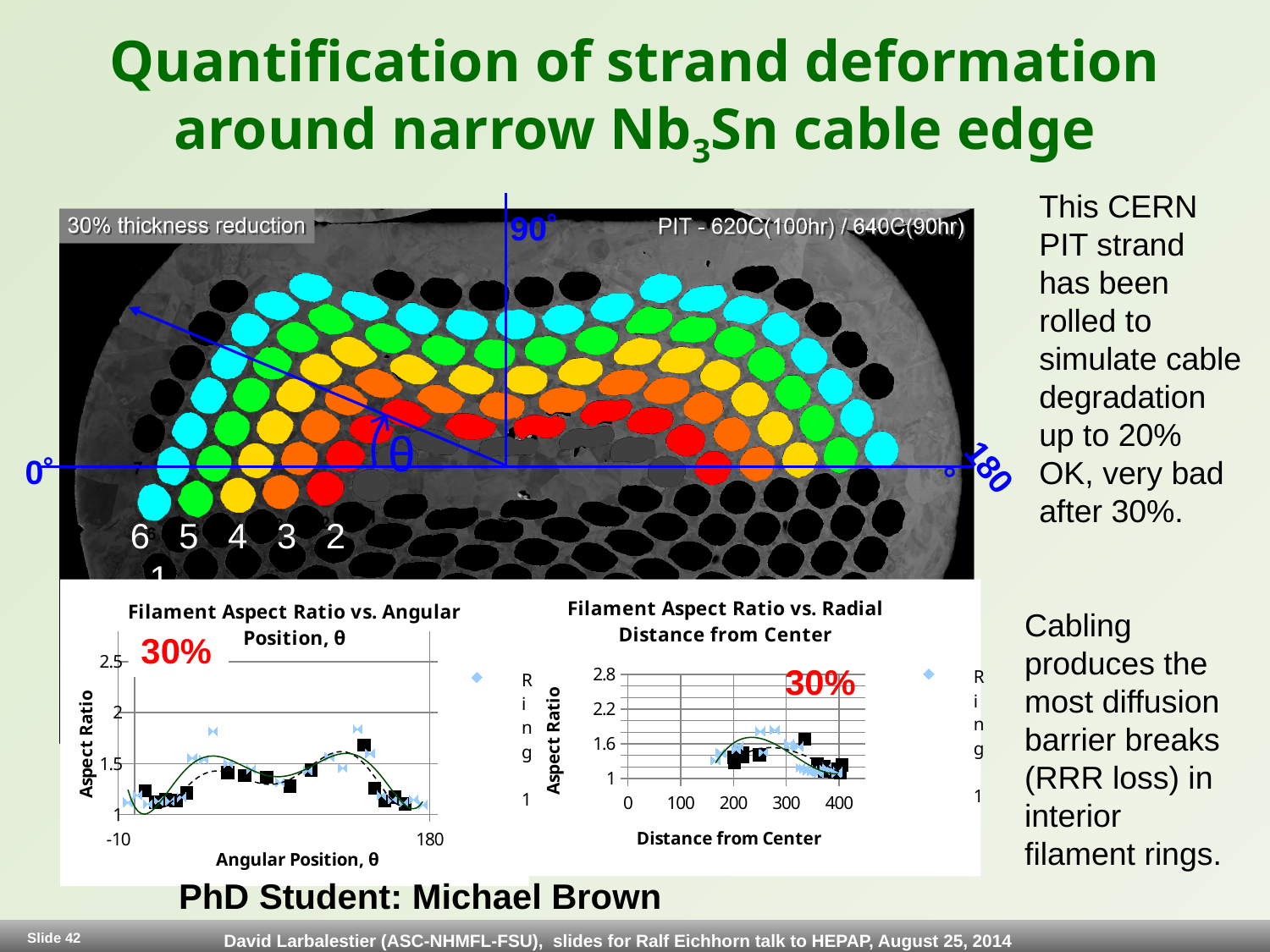
In the left chart (Filament Aspect Ratio vs. Angular Position), what are the minimum and maximum tick values shown on the x axis? -10 and 180 What kind of chart is the right chart titled "Filament Aspect Ratio vs. Radial Distance from Center"? scatter chart In the left chart (Filament Aspect Ratio vs. Angular Position), what is the label on the y axis? Aspect Ratio What kind of chart is the left chart titled "Filament Aspect Ratio vs. Angular Position, θ"? scatter chart In the right chart (Filament Aspect Ratio vs. Radial Distance from Center), what is the label on the x axis? Distance from Center In the left chart (Filament Aspect Ratio vs. Angular Position), is the highest plotted aspect ratio greater or less than 2? less In the right chart (Filament Aspect Ratio vs. Radial Distance from Center), are the plotted points at a distance of about 400 greater or less than 1.6 in aspect ratio? less In the right chart (Filament Aspect Ratio vs. Radial Distance from Center), what is the largest tick value shown on the y axis? 2.8 In the right chart (Filament Aspect Ratio vs. Radial Distance from Center), is the highest plotted aspect ratio greater or less than 2.2? less